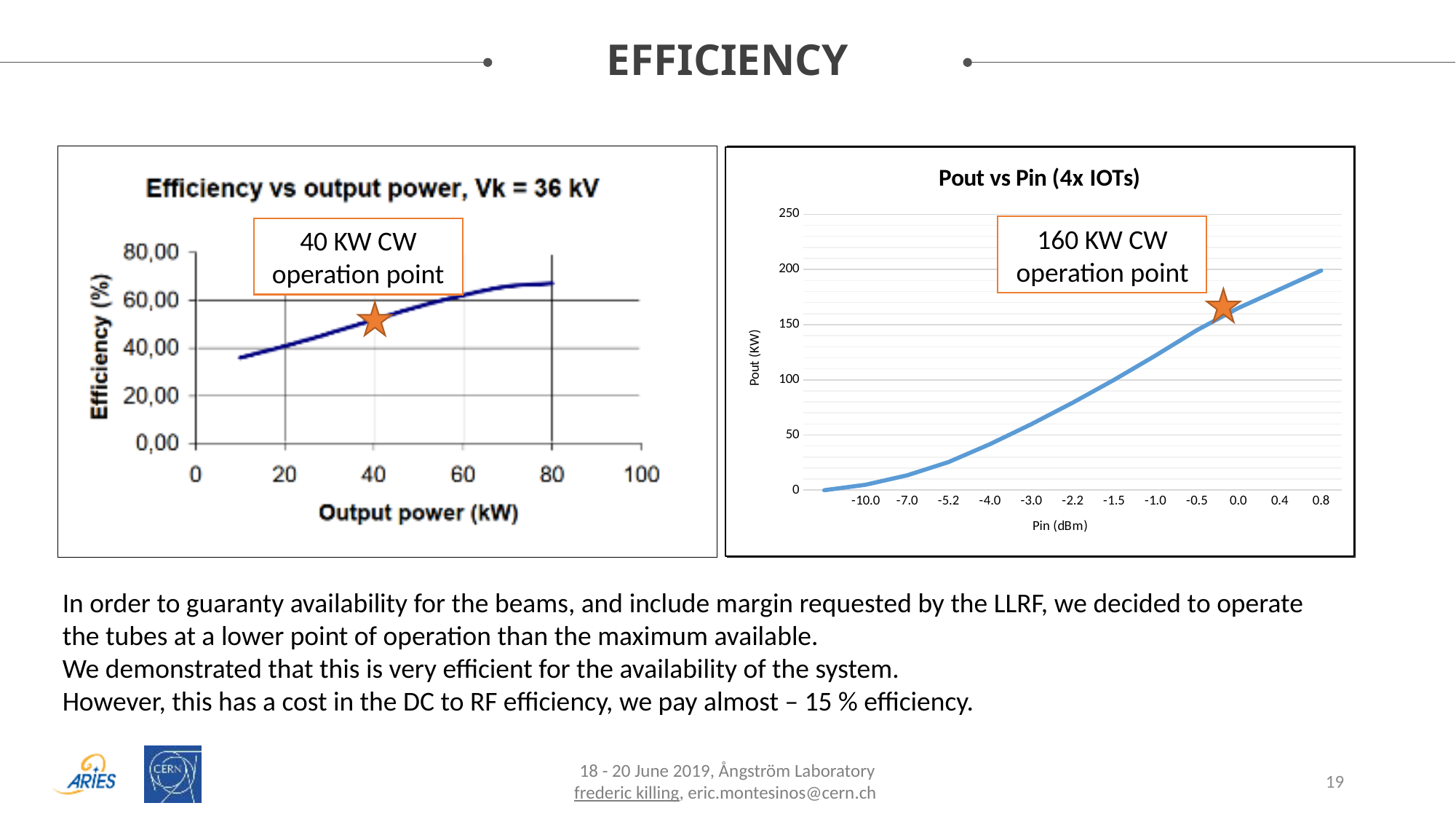
What kind of chart is the right chart titled 'Pout vs Pin (4x IOTs)'? line chart In the right chart 'Pout vs Pin (4x IOTs)', is Pout at Pin = -1.0 dBm greater or less than 100? greater In the left chart 'Efficiency vs output power', does efficiency rise or fall as output power increases? rise In the right chart 'Pout vs Pin (4x IOTs)', does Pout rise or fall as Pin increases? rise What is the x-axis label of the right chart 'Pout vs Pin (4x IOTs)'? Pin (dBm) In the right chart 'Pout vs Pin (4x IOTs)', is Pout at Pin = -5.2 dBm greater or less than 50? less In the left chart 'Efficiency vs output power', is the efficiency at 80 kW output power greater or less than 60? greater What kind of chart is the left chart titled 'Efficiency vs output power, Vk = 36 kV'? line chart What operation point is marked with a star on the left chart 'Efficiency vs output power'? 40 KW CW operation point